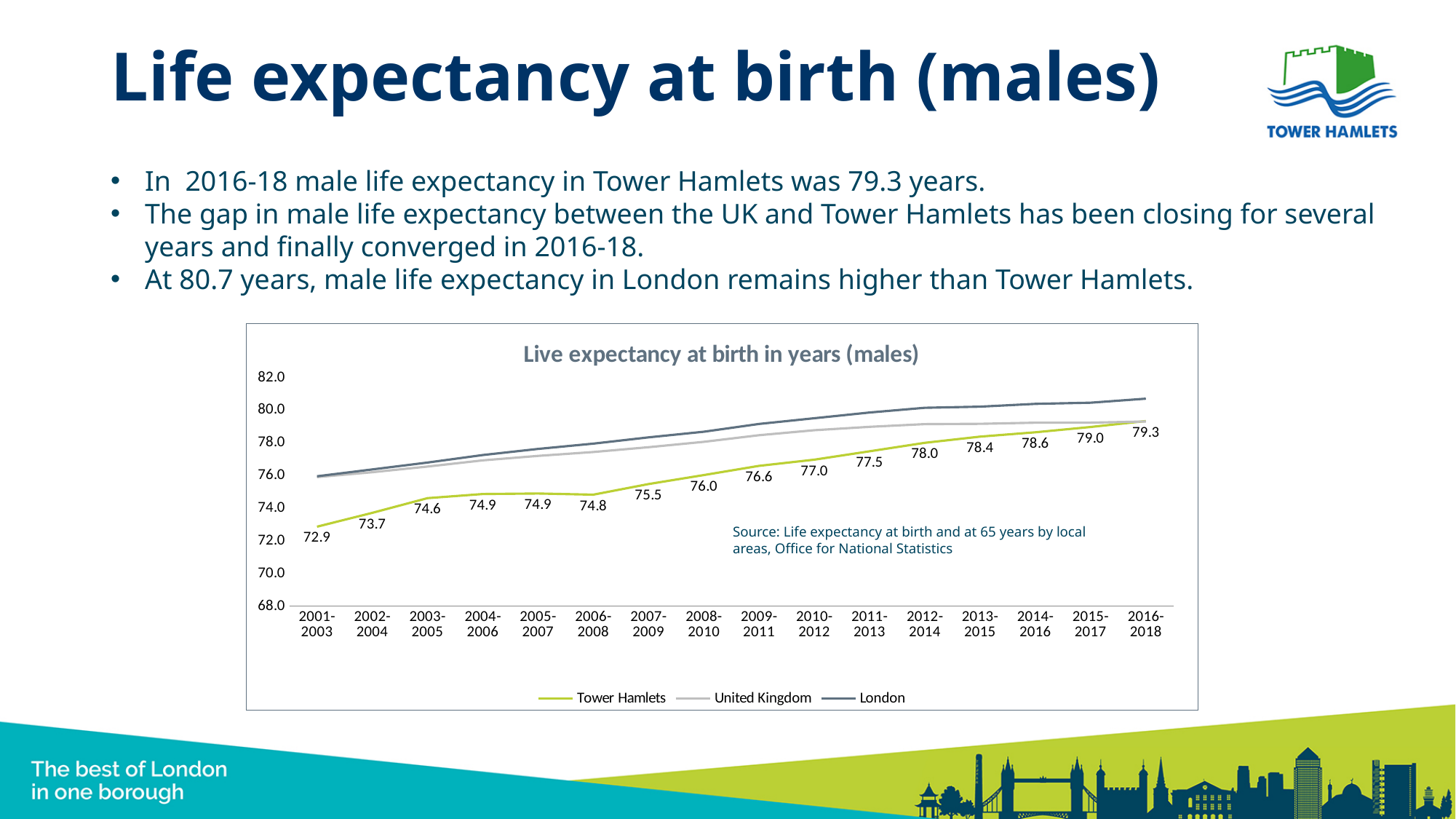
Does the Tower Hamlets line generally rise or fall from 2001-2003 to 2016-2018? Rise By how much did the Tower Hamlets value increase from 2001-2003 to 2016-2018? 6.4 Is the London value for 2016-2018 greater or less than 80.0? greater In which period is the Tower Hamlets line at its highest value? 2016-2018 What is the Tower Hamlets value for 2009-2011? 76.6 Which is larger for Tower Hamlets: the value for 2005-2007 or the value for 2006-2008? 2005-2007 In which period is the Tower Hamlets line at its lowest value? 2001-2003 How many time periods are shown on the x axis of the chart? 16 What is the Tower Hamlets male life expectancy value for 2001-2003? 72.9 How many series does the chart legend list? 3 What kind of chart is shown on the slide? Line chart What is the Tower Hamlets value for 2016-2018 in the chart? 79.3